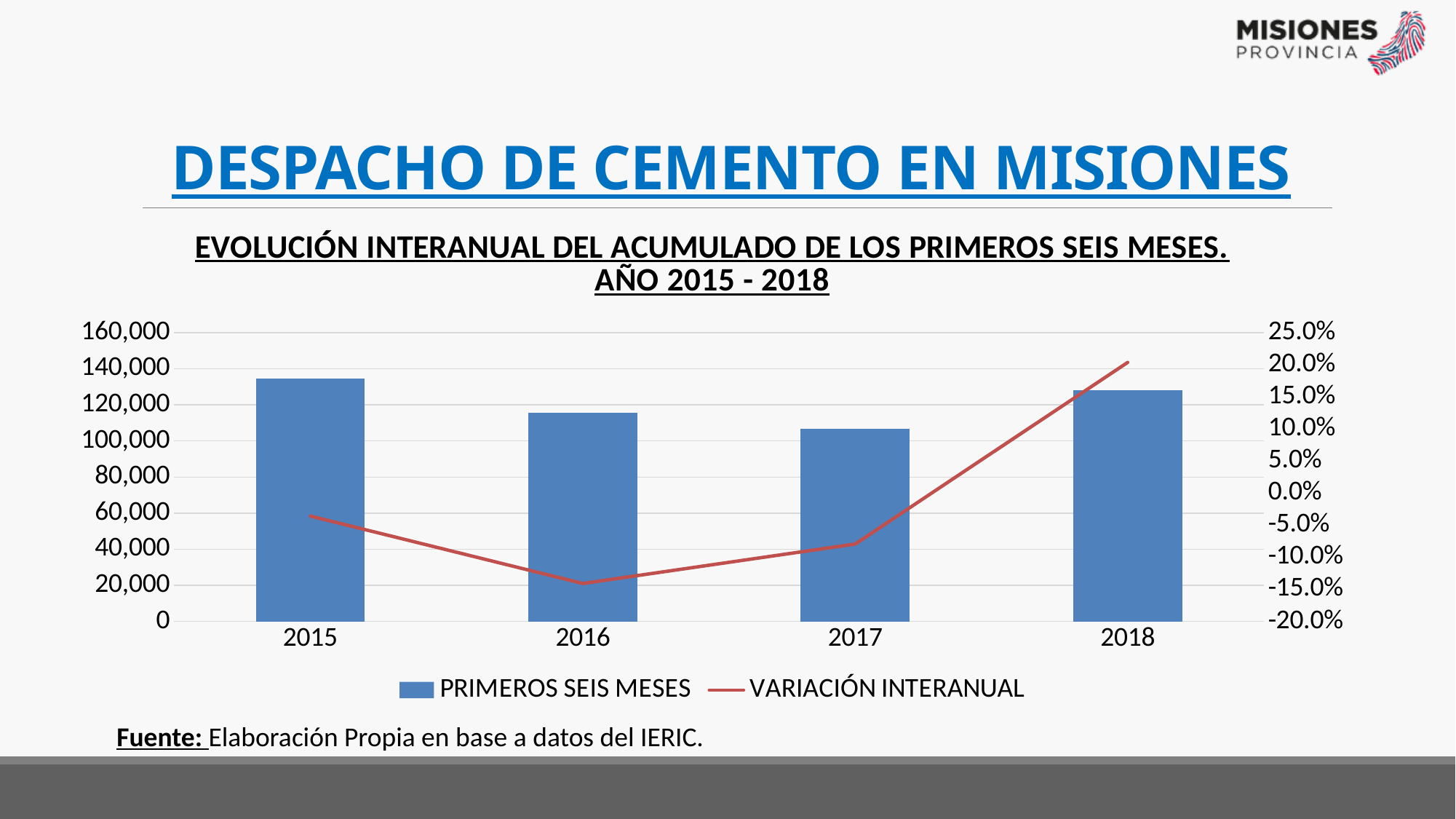
Which year has the lowest bar for PRIMEROS SEIS MESES? 2017 Does the VARIACIÓN INTERANUAL line rise or fall from 2016 to 2018? rise Is the PRIMEROS SEIS MESES bar for 2015 greater or less than 120,000? greater Is the VARIACIÓN INTERANUAL value for 2018 greater or less than 15.0%? greater How many years are shown on the x axis of the chart? 4 Which year has a larger PRIMEROS SEIS MESES bar, 2016 or 2018? 2018 How many series does the chart legend list? 2 Which year has the highest bar for PRIMEROS SEIS MESES? 2015 In which year is the VARIACIÓN INTERANUAL line at its lowest point? 2016 Is the PRIMEROS SEIS MESES bar for 2017 greater or less than 120,000? less What kind of chart is shown on the slide? A combined bar and line chart